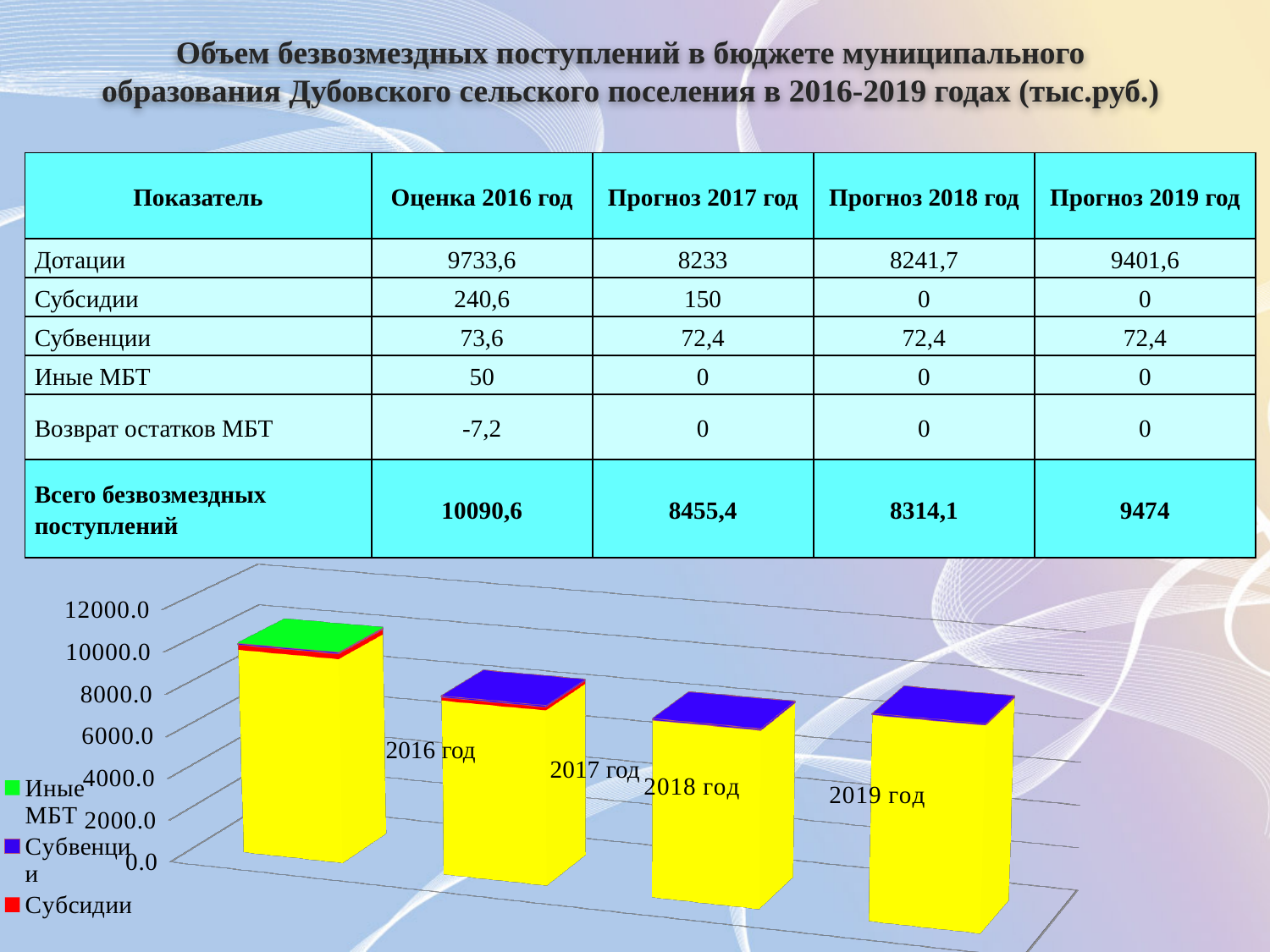
Is the total height of the bar for 2018 год greater or less than 10000.0? less What kind of chart is shown at the bottom of the slide? bar chart How many series does the chart legend list? 3 Is the total height of the bar for 2019 год greater or less than 6000.0? greater Is the total height of the bar for 2017 год greater or less than 6000.0? greater What colour represents the series Субсидии in the chart legend? red How many year categories are plotted along the x axis of the chart? 4 Which bar is taller in the chart, 2016 год or 2017 год? 2016 год Which series is shown in green in the chart legend? Иные МБТ What is the highest value shown on the chart's vertical axis? 12000.0 Which year has the tallest bar in the chart? 2016 год